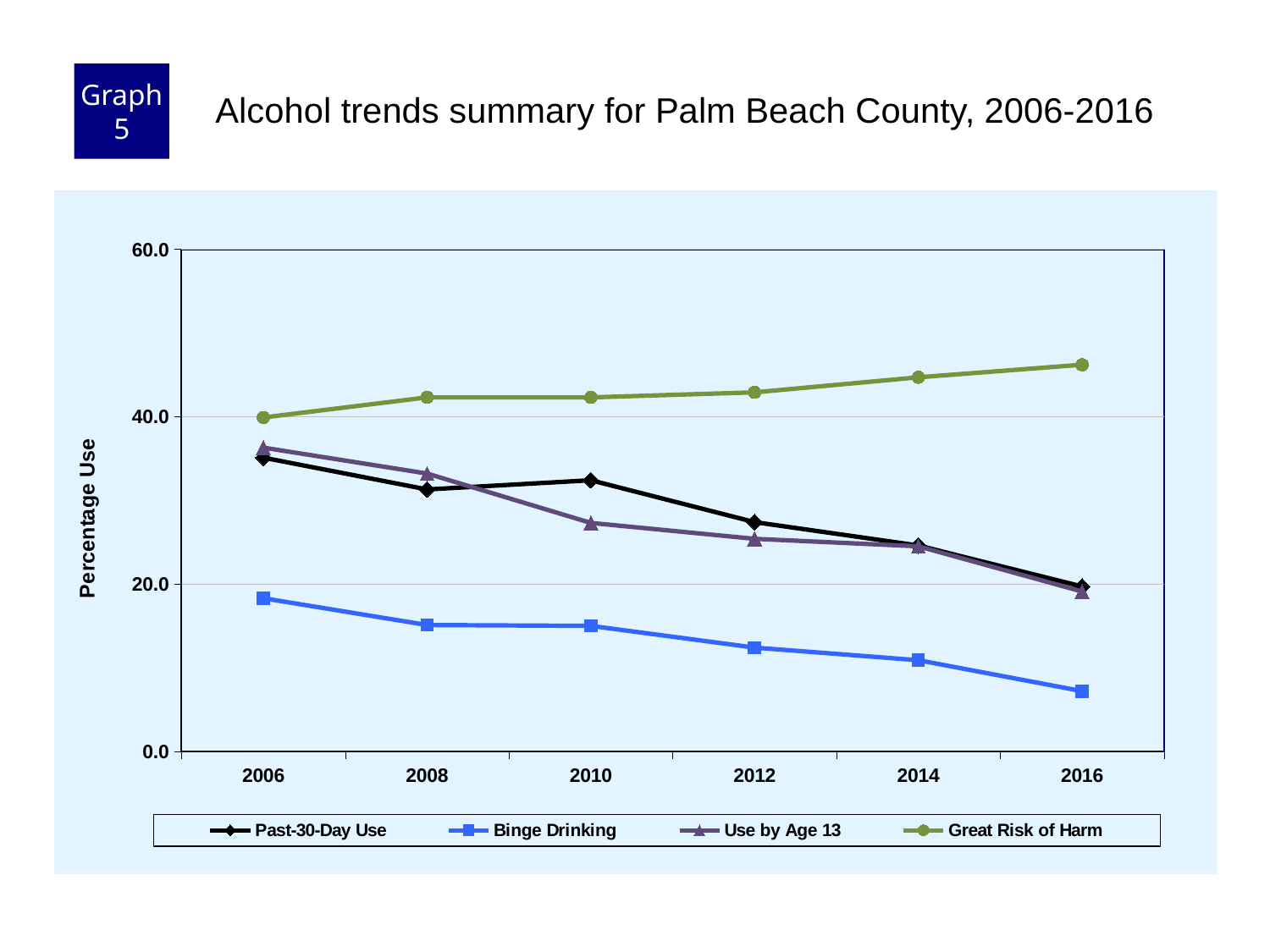
Is the value for Binge Drinking in 2016 greater or less than 20.0? less What is the label on the y axis? Percentage Use Is the value for Great Risk of Harm in 2016 greater or less than 40.0? greater How many years are plotted along the x axis? 6 In 2010, which is larger: Past-30-Day Use or Use by Age 13? Past-30-Day Use Which series has the highest value in 2016? Great Risk of Harm What kind of chart is shown on the slide? Line chart How many series does the legend list? 4 Does the Great Risk of Harm line rise or fall from 2006 to 2016? Rises Is the value for Past-30-Day Use in 2006 greater or less than 40.0? less Does the Binge Drinking line rise or fall from 2006 to 2016? Falls Which series has the lowest value in 2006? Binge Drinking